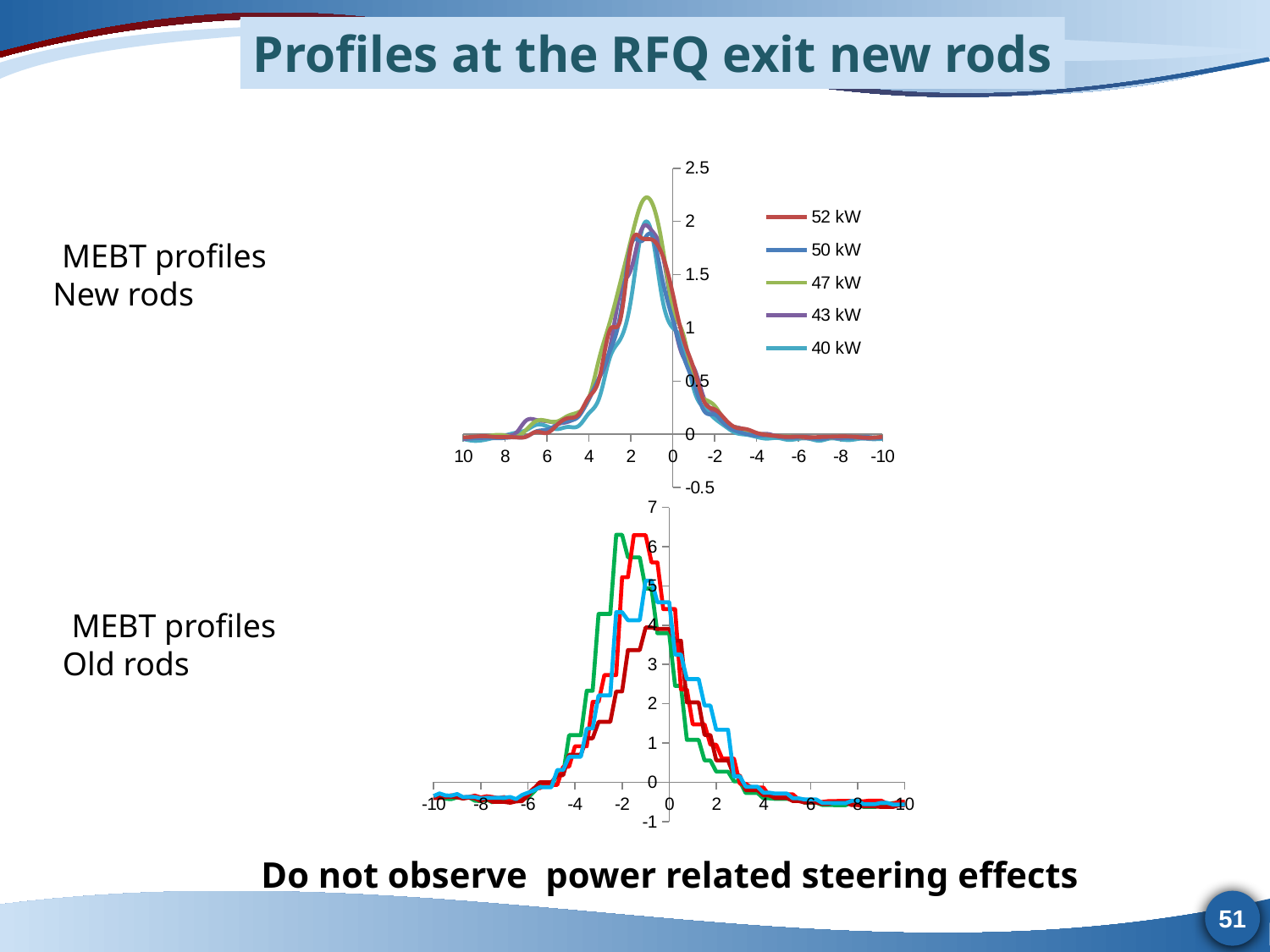
What kind of chart is the bottom chart (MEBT profiles Old rods)? line chart In the top chart (MEBT profiles New rods), how many series does the legend list? 5 In the top chart (MEBT profiles New rods), which series reaches the highest peak? 47 kW In the top chart (MEBT profiles New rods), is the peak value of the 52 kW series greater or less than 2? less In the top chart (MEBT profiles New rods), is the peak value of the 47 kW series greater or less than 2? greater In the bottom chart (MEBT profiles Old rods), is the peak of the green line higher or lower than the peak of the light blue line? higher In the top chart (MEBT profiles New rods), is the peak of the 47 kW series higher or lower than the peak of the 40 kW series? higher What kind of chart is the top chart (MEBT profiles New rods)? line chart What is the highest value shown on the vertical axis of the bottom chart (MEBT profiles Old rods)? 7 In the top chart (MEBT profiles New rods), which legend entry is shown in green? 47 kW In the bottom chart (MEBT profiles Old rods), is the peak value of the green line greater or less than 6? greater